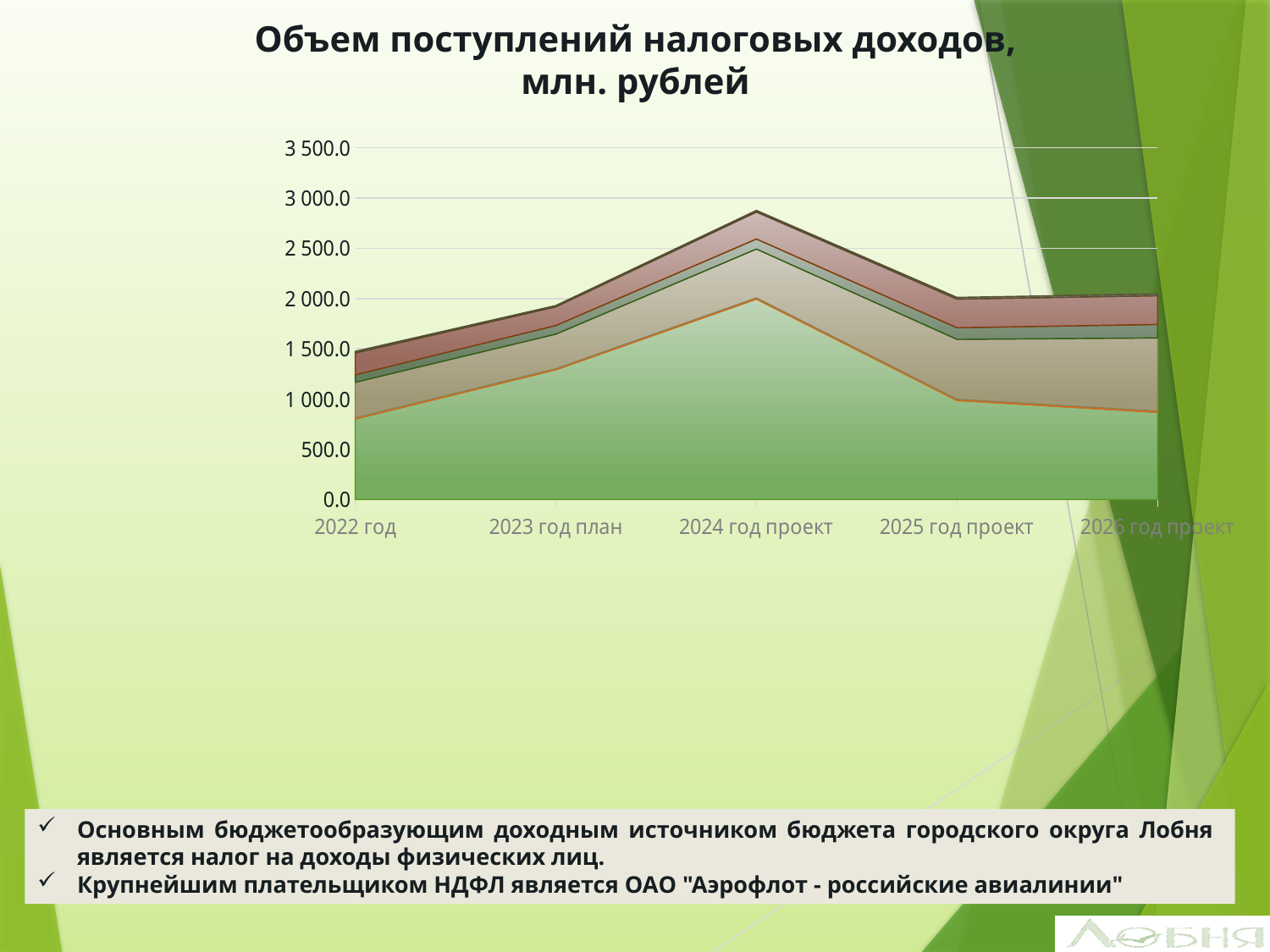
Do the total values rise or fall from 2022 год to 2024 год проект? rise Is the total value for 2023 год план greater or less than 1 500.0? greater How many categories are shown on the x axis of the chart? 5 Is the value of the bottom (green) series for 2022 год greater or less than 1 000.0? less Do the total values rise or fall from 2024 год проект to 2025 год проект? fall Which category has the highest total value in the chart? 2024 год проект Which category has the lowest total value in the chart? 2022 год What kind of chart is shown on the slide? Area chart Is the total value for 2024 год проект greater or less than 2 500.0? greater Which has the larger total value: 2024 год проект or 2022 год? 2024 год проект What is the title of the chart? Объем поступлений налоговых доходов, млн. рублей